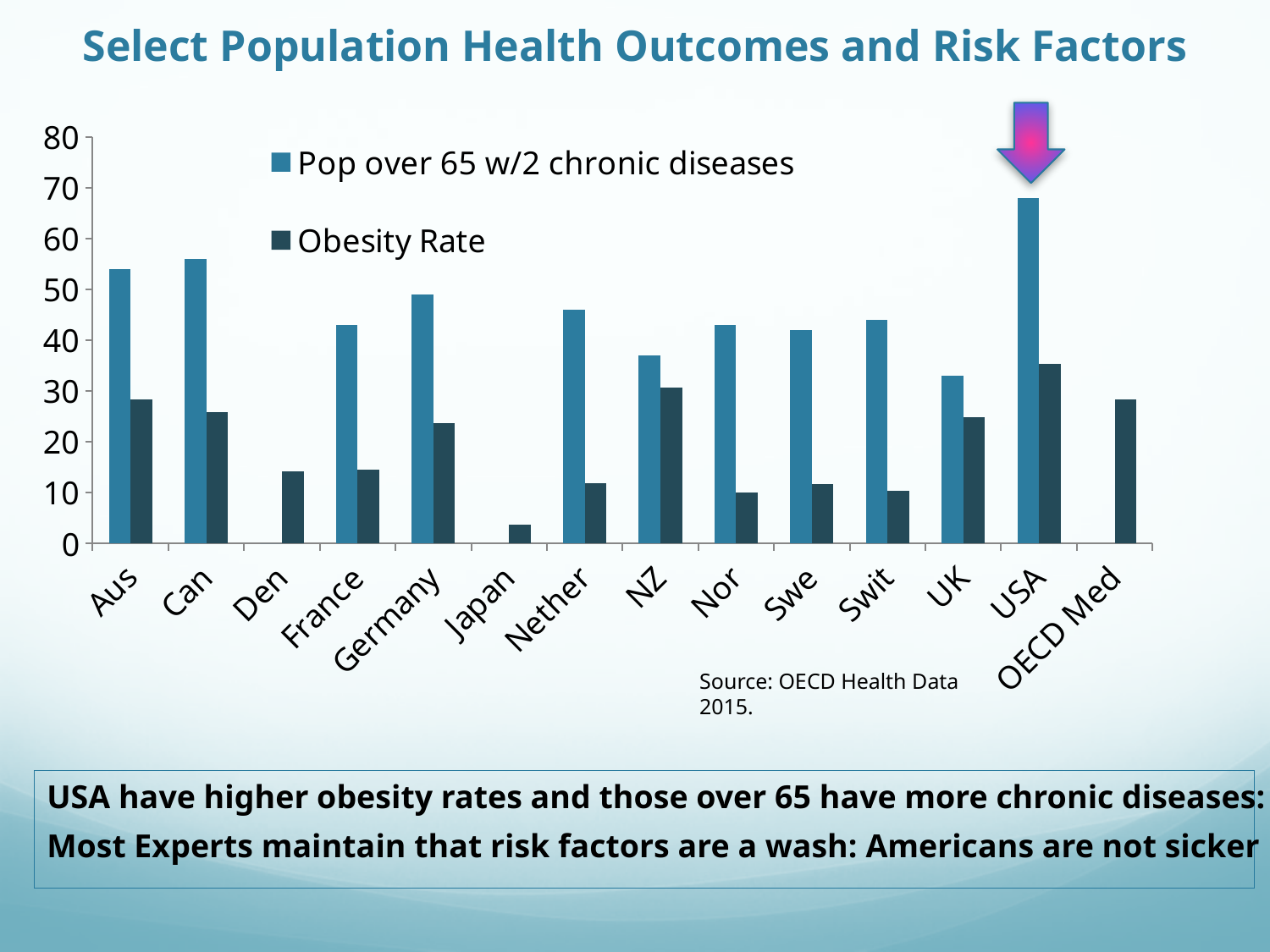
What kind of chart is shown on the slide? bar chart How many categories are shown along the x axis? 14 Is the value for Nether in the Pop over 65 w/2 chronic diseases series greater or less than 50? less Which category has the lowest Obesity Rate? Japan Which category has the highest Obesity Rate? USA Is the value for USA in the Pop over 65 w/2 chronic diseases series greater or less than 60? greater Is the Obesity Rate for Germany greater or less than 30? less Which has a higher value for Pop over 65 w/2 chronic diseases, Germany or France? Germany Which category has the highest value for Pop over 65 w/2 chronic diseases? USA Which has a higher Obesity Rate, USA or UK? USA How many series does the legend list? 2